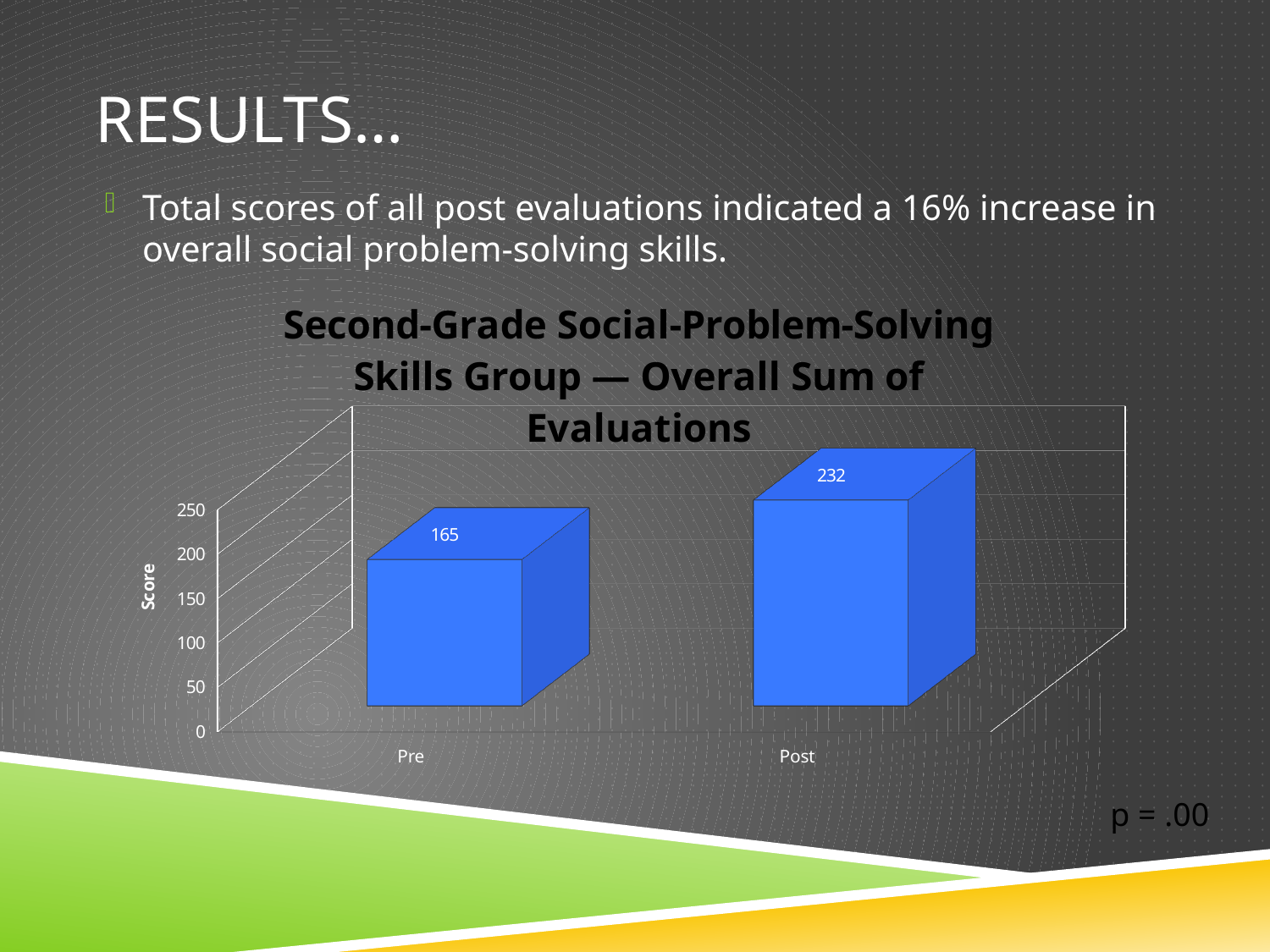
What kind of chart is shown on the slide? bar chart Do the values rise or fall from Pre to Post? rise What is the score for Post? 232 What is the difference between the Post and Pre scores? 67 Which is larger, the Pre score or the Post score? Post What is the label of the vertical axis? Score What is the score for Pre? 165 Is the value for Pre greater or less than 200? less Which category has the highest score? Post Is the value for Post greater or less than 200? greater How many categories are shown on the x axis? 2 Which category has the lowest score? Pre